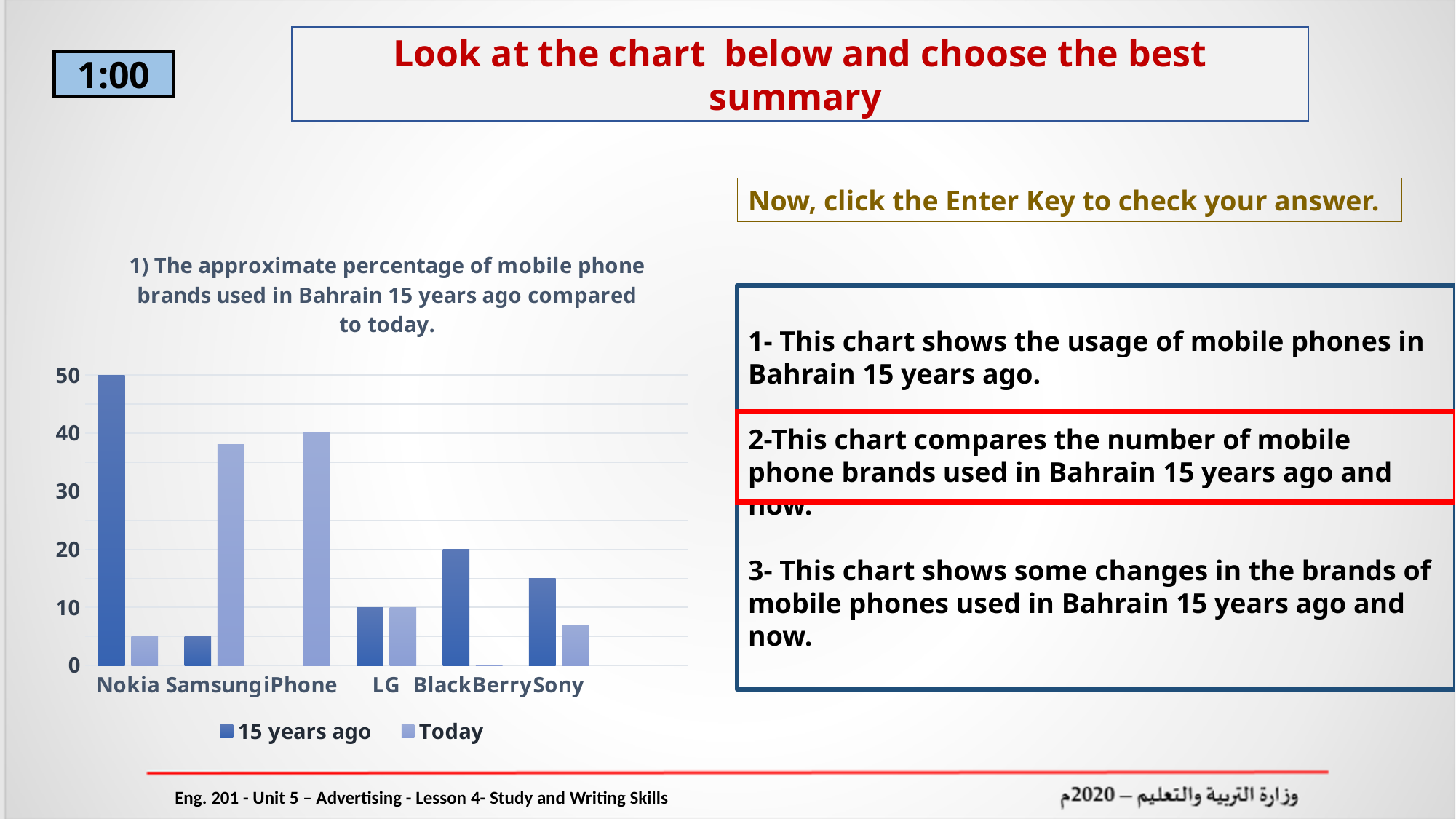
What is the value for BlackBerry in the '15 years ago' series? 20 What kind of chart is shown on the slide? bar chart Which brand has the highest value in the '15 years ago' series? Nokia What is the value for iPhone in the 'Today' series? 40 What is the value for Nokia in the '15 years ago' series? 50 What is the value for LG in the '15 years ago' series? 10 How many mobile phone brands are shown on the x axis of the chart? 6 Is the value for Samsung in the 'Today' series greater or less than 30? greater For Nokia, which series has the larger value: '15 years ago' or 'Today'? 15 years ago How many series does the chart's legend list? 2 What is the difference between the '15 years ago' values for Nokia and BlackBerry? 30